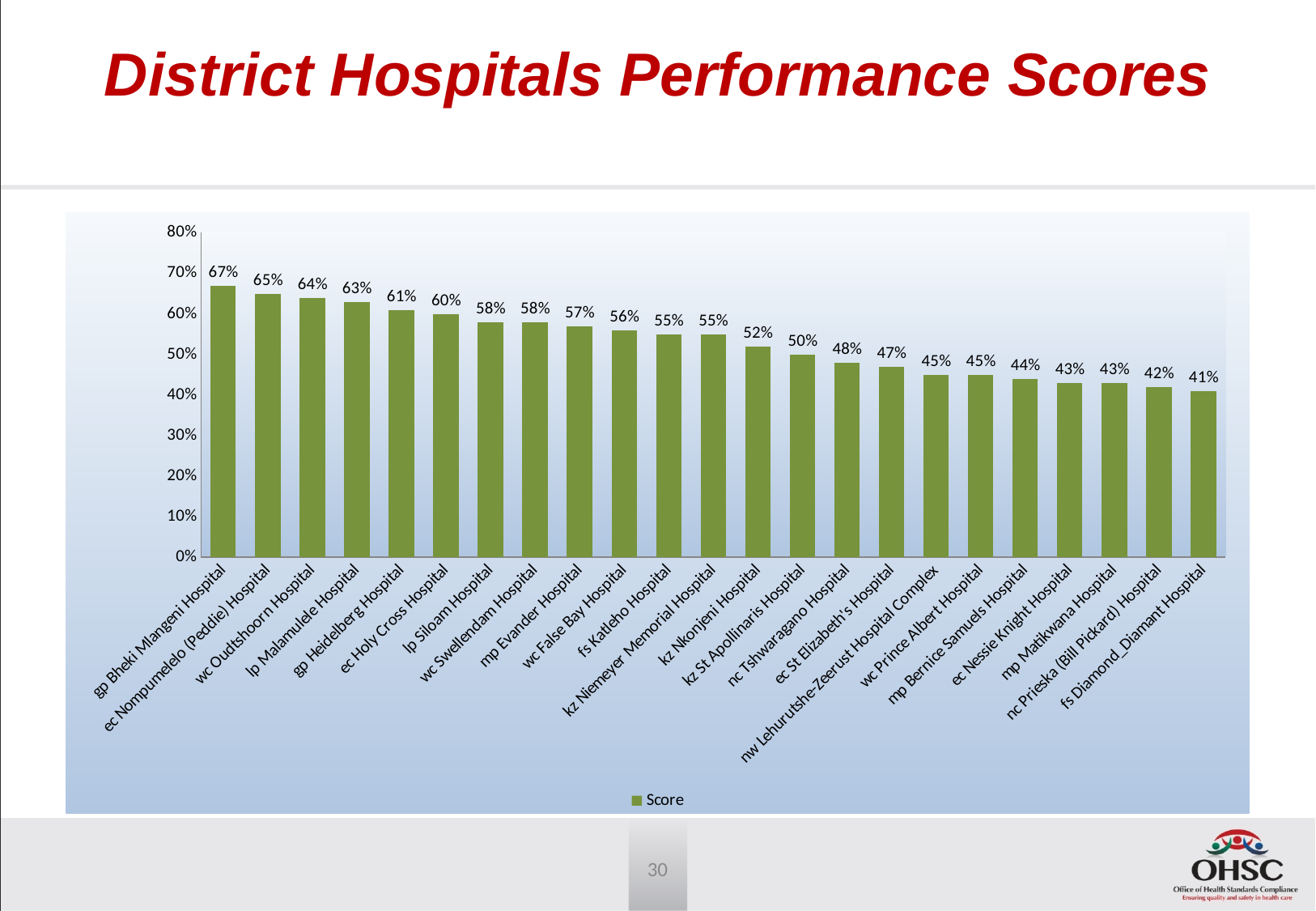
What is the score for kz Nkonjeni Hospital? 52% How many hospitals are shown in the chart? 23 Is the score for mp Bernice Samuels Hospital greater or less than 50%? less Which hospital has the lowest score? fs Diamond_Diamant Hospital Which hospital has the highest score? gp Bheki Mlangeni Hospital What is the difference between the scores of wc Oudtshoorn Hospital and mp Evander Hospital? 7% How many series does the legend list? 1 What kind of chart is shown on the slide? bar chart Do the scores rise or fall from left to right along the x axis? fall What is the score for gp Bheki Mlangeni Hospital? 67% Which has a higher score, ec Holy Cross Hospital or kz St Apollinaris Hospital? ec Holy Cross Hospital What is the score for nc Tshwaragano Hospital? 48%